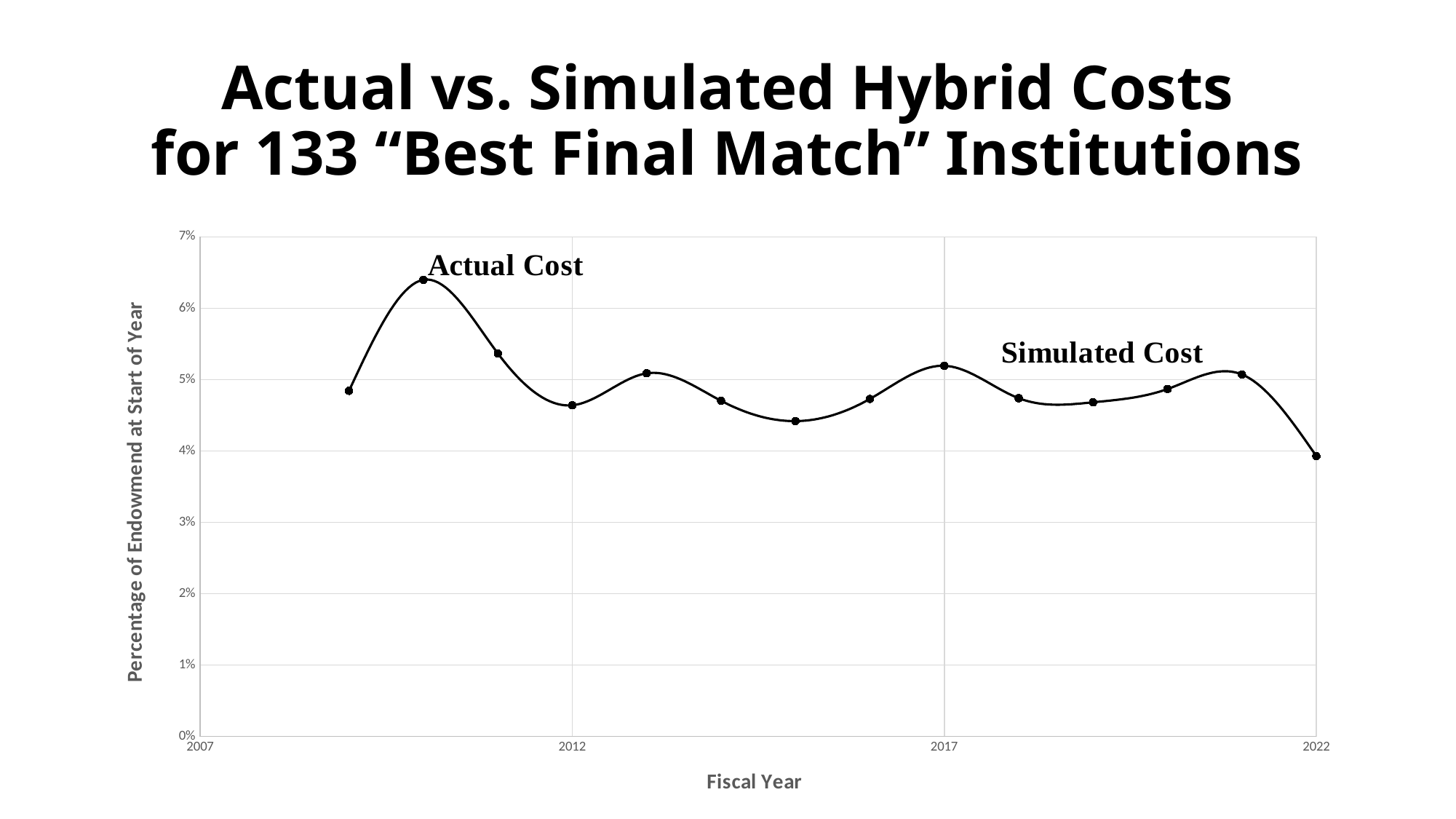
In which fiscal year does the plotted cost reach its highest value? 2010 What is the title of the vertical axis? Percentage of Endowmend at Start of Year Is the value for fiscal year 2015 greater or less than 5%? less Is the value for fiscal year 2010 greater or less than 6%? greater How many data points are plotted on the line? 14 What kind of chart is shown on the slide? Line chart Is the value for fiscal year 2017 greater or less than 5%? greater Which fiscal year has the larger value, 2010 or 2022? 2010 Does the plotted cost rise or fall between fiscal years 2021 and 2022? Fall What is the title of the horizontal axis? Fiscal Year In which fiscal year does the plotted cost reach its lowest value? 2022